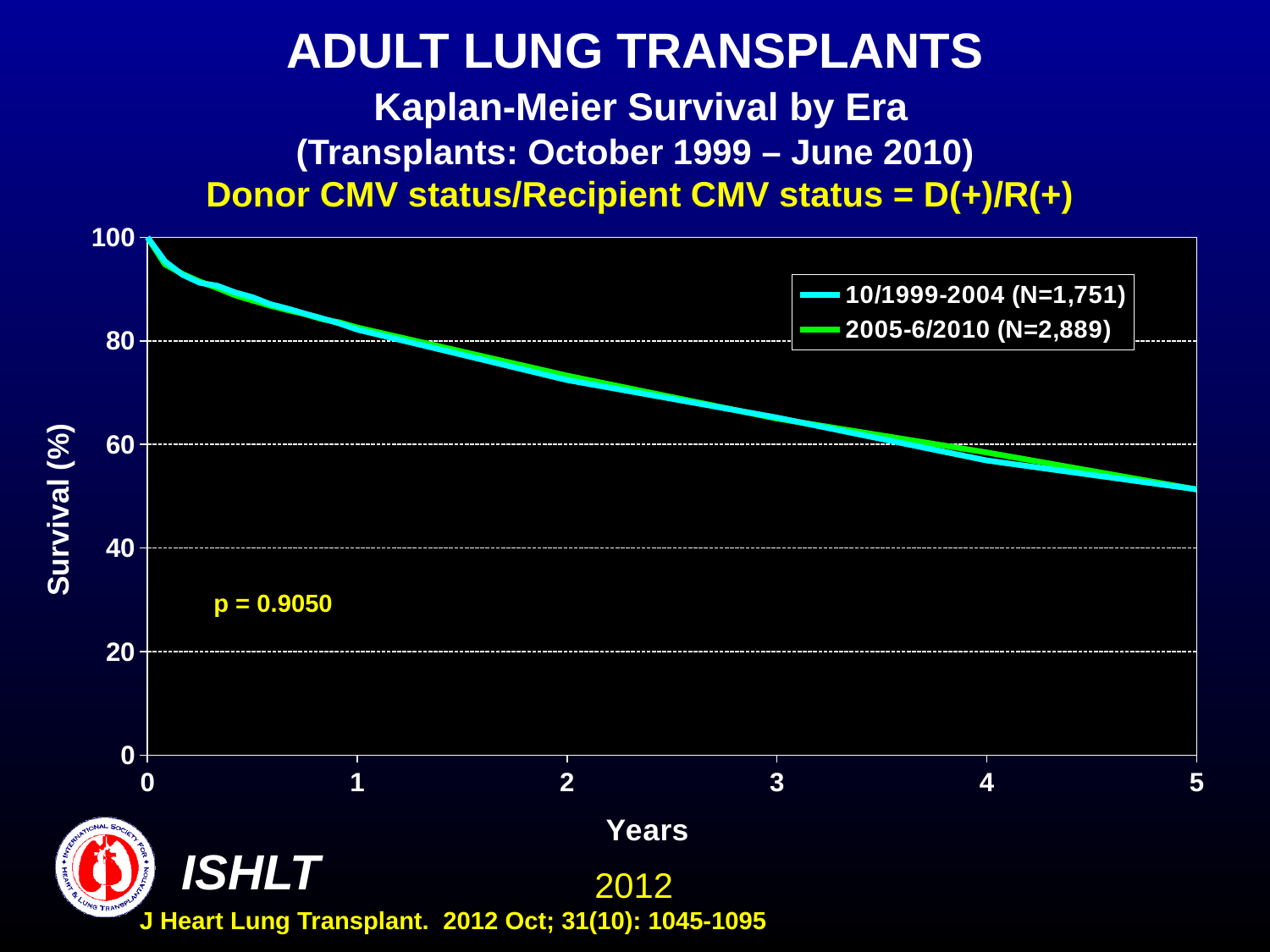
What kind of chart is shown on the slide? line chart Is the survival value for the 2005-6/2010 series at 5 years greater or less than 60? less What is the sample size (N) shown in the legend for the 2005-6/2010 series? N=2,889 What is the survival value for both series at 0 years? 100 Is the survival value for the 10/1999-2004 series at 3 years greater or less than 60? greater Is the survival value for the 2005-6/2010 series at 5 years greater or less than 40? greater What p-value is printed on the chart? p = 0.9050 Do the survival curves rise or fall as the years increase along the x axis? fall How many series does the legend list? 2